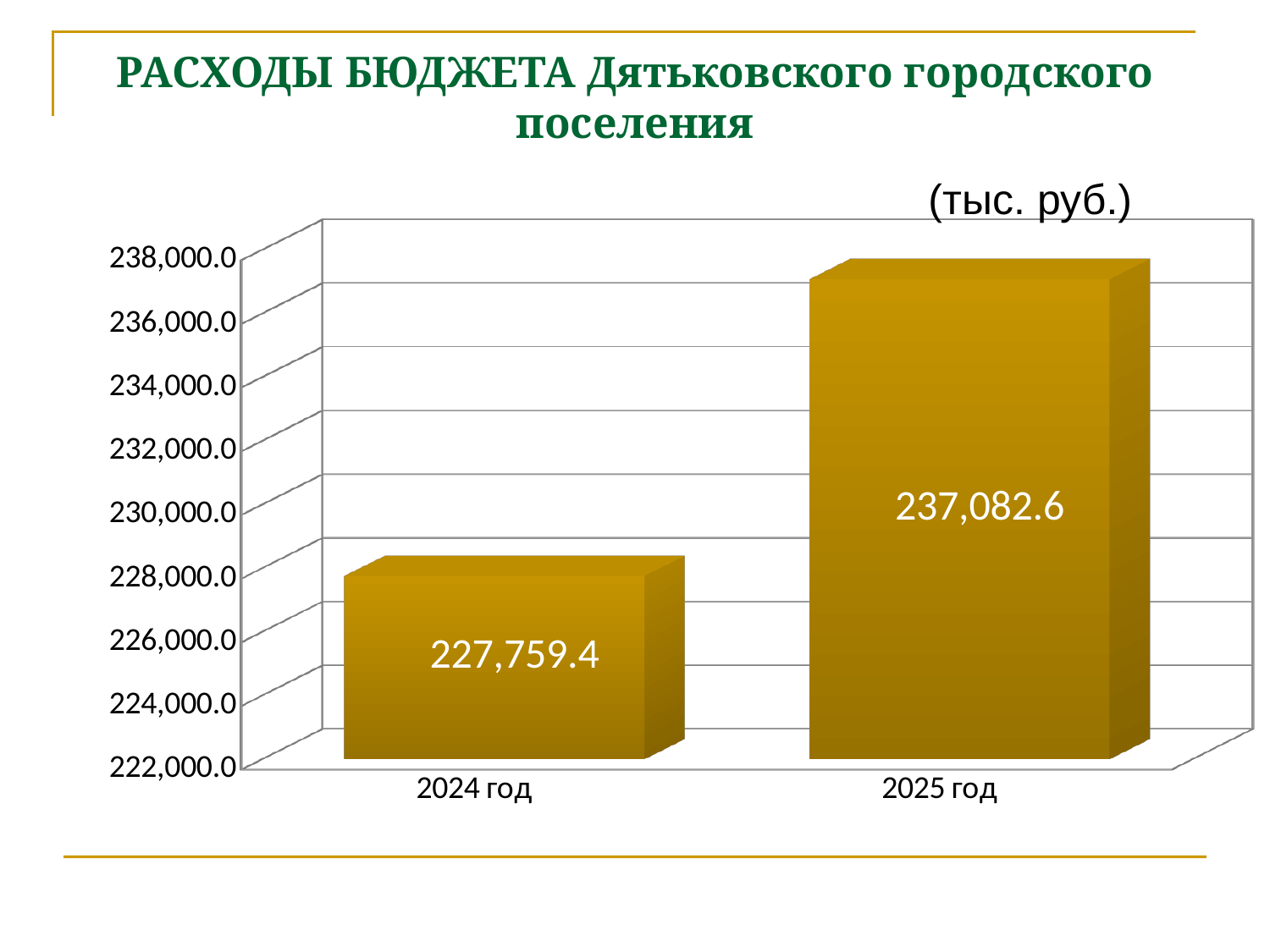
What is the difference between the values for 2025 год and 2024 год? 9,323.2 Which year has the lowest value? 2024 год Which year has the highest value? 2025 год Which is larger, the value for 2024 год or the value for 2025 год? 2025 год What kind of chart is shown on the slide? bar chart In what units are the values on the chart expressed? тыс. руб. Is the value for 2024 год greater or less than 228,000.0? less Is the value for 2025 год greater or less than 236,000.0? greater What is the value for 2025 год? 237,082.6 What is the value for 2024 год? 227,759.4 Do the values rise or fall from 2024 год to 2025 год? rise How many categories are shown on the x axis? 2